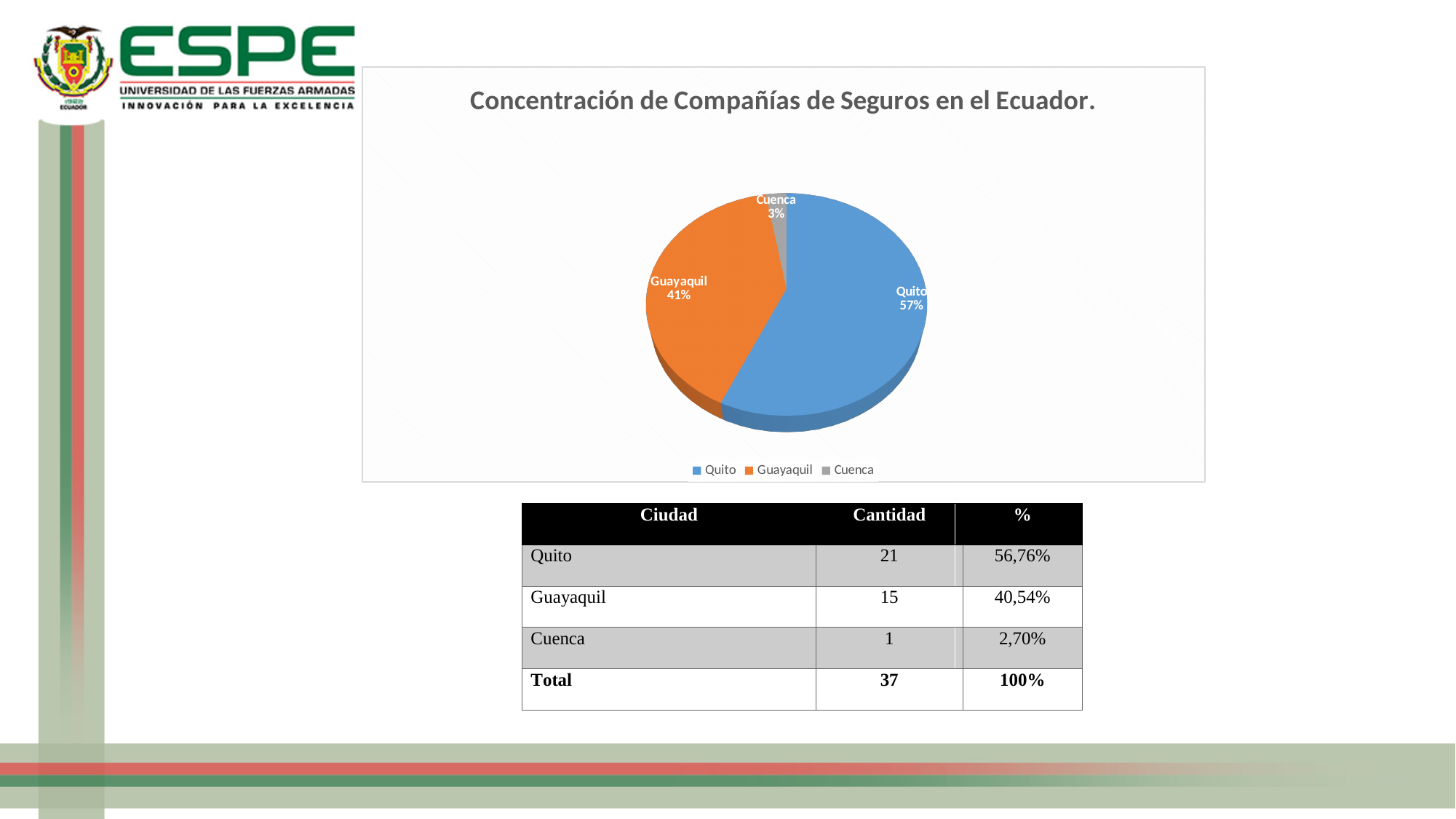
What is the difference in percentage points between the Quito and Guayaquil slices? 16 Which city has the smallest slice of the pie? Cuenca What is the title of the chart? Concentración de Compañías de Seguros en el Ecuador. Which slice is larger, Guayaquil or Cuenca? Guayaquil What colour is the Guayaquil slice? Orange How many entries does the legend list? 3 What percentage does the Guayaquil slice show? 41% What percentage does the Cuenca slice show? 3% How many slices does the pie chart have? 3 What percentage does the Quito slice show? 57% Which city has the largest slice of the pie? Quito What type of chart is shown on the slide? Pie chart